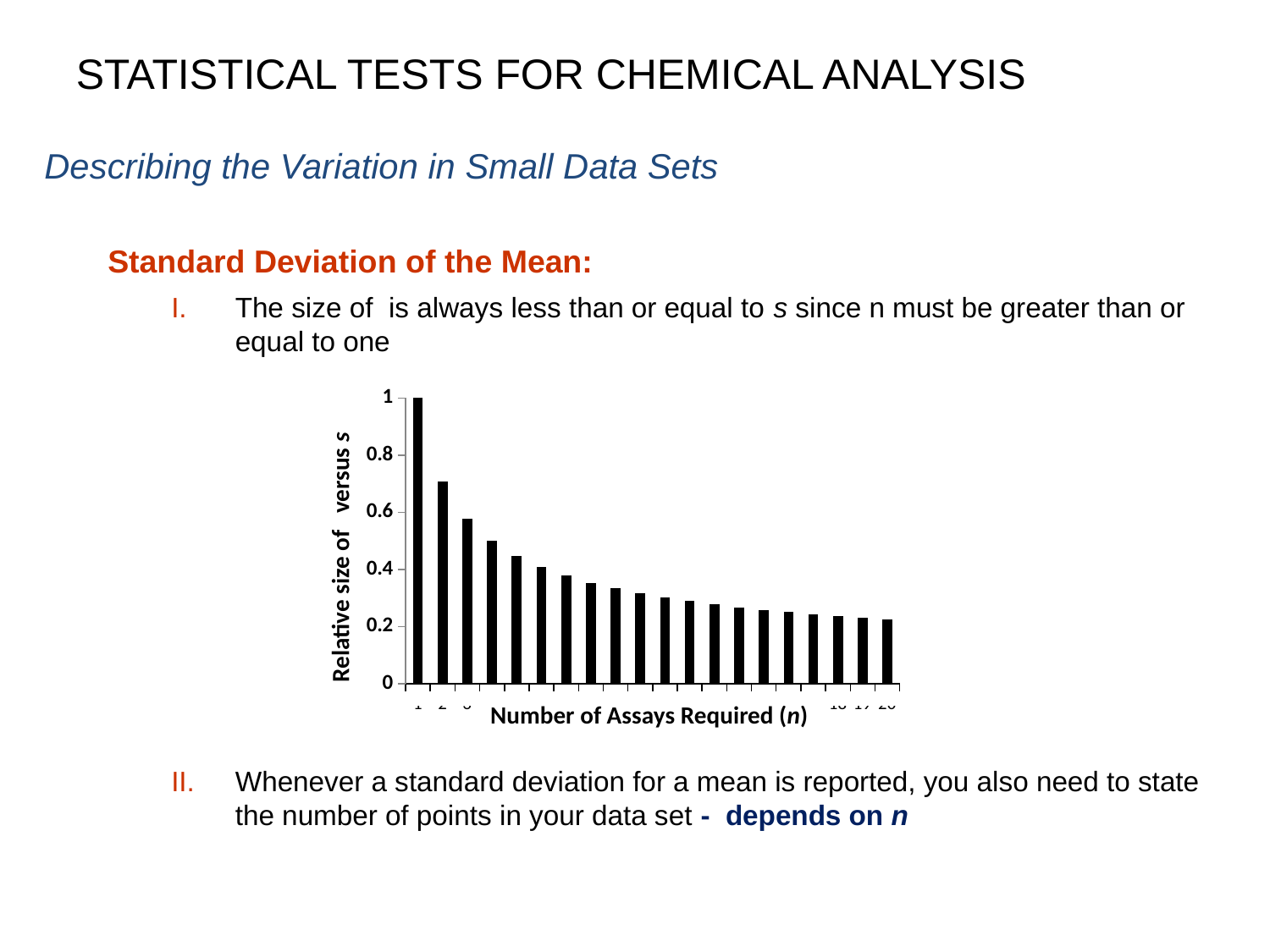
What kind of chart is shown on the slide? bar chart Do the bar values rise or fall as the number of assays increases along the x axis? fall Which is larger, the value of the second bar or the value of the fifth bar? the second bar What is the highest tick value shown on the y axis of the chart? 1 Which bar has the lowest value in the chart? the last bar (n = 20) Is the value of the last (rightmost) bar greater or less than 0.4? less How many bars are plotted in the chart? 20 Is the value of the tenth bar greater or less than 0.4? less What is the value of the first (leftmost) bar in the chart? 1 What is the label of the x axis of the chart? Number of Assays Required (n) Which bar has the highest value in the chart? the first bar (n = 1) Is the value of the second bar greater or less than 0.6? greater